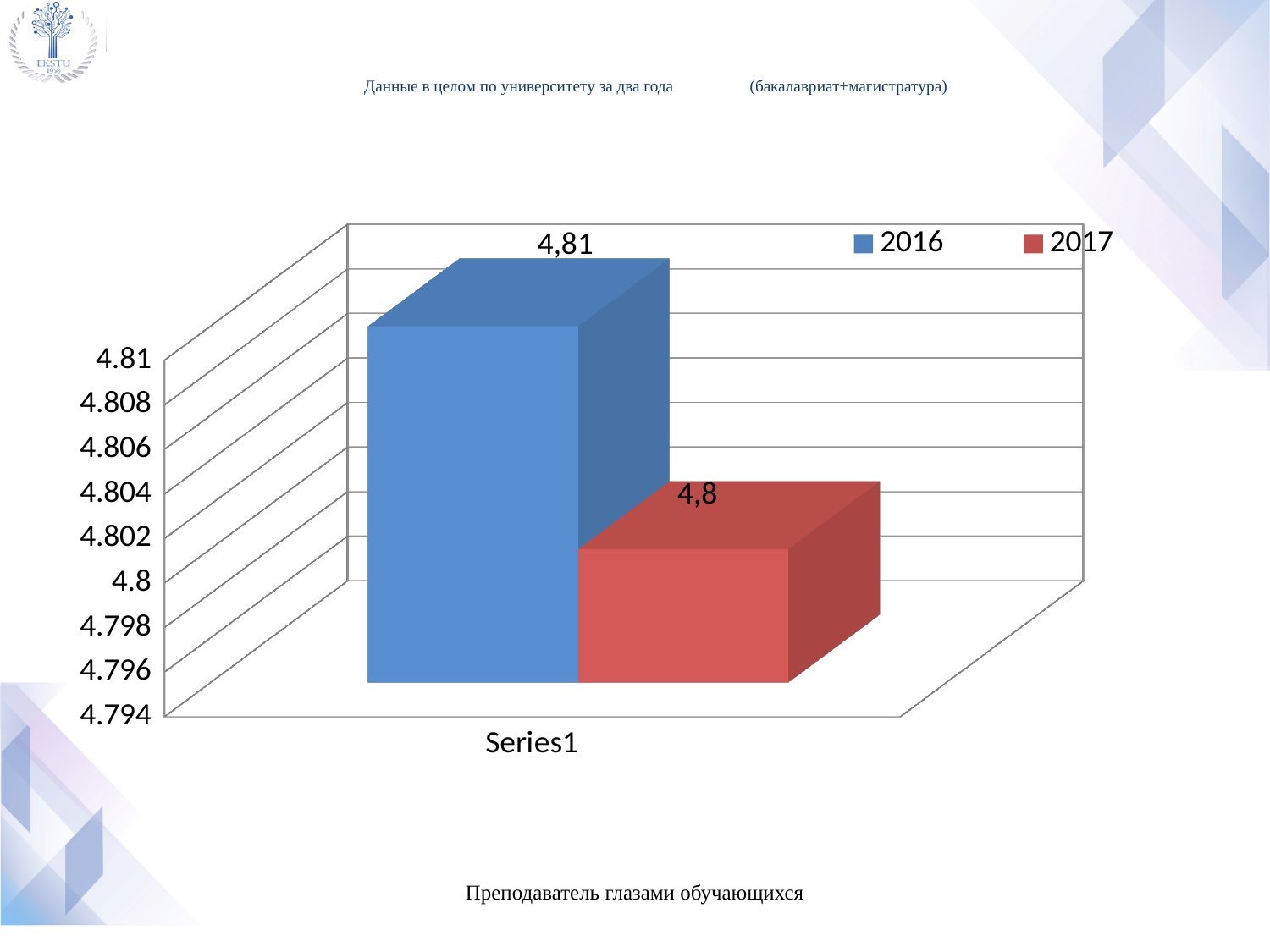
How many series does the legend list? 2 How many categories are shown on the x axis? 1 What is the value for 2016 shown on the chart? 4,81 What kind of chart is shown on the slide? bar chart What colour is the bar for 2017? red Which series has the lowest value on the chart? 2017 Did the value rise or fall from 2016 to 2017? fell What is the difference between the 2016 value and the 2017 value? 0,01 Which series has the higher value, 2016 or 2017? 2016 Is the value for 2016 greater or less than 4.8? greater Which series has the highest value on the chart? 2016 What is the value for 2017 shown on the chart? 4,8